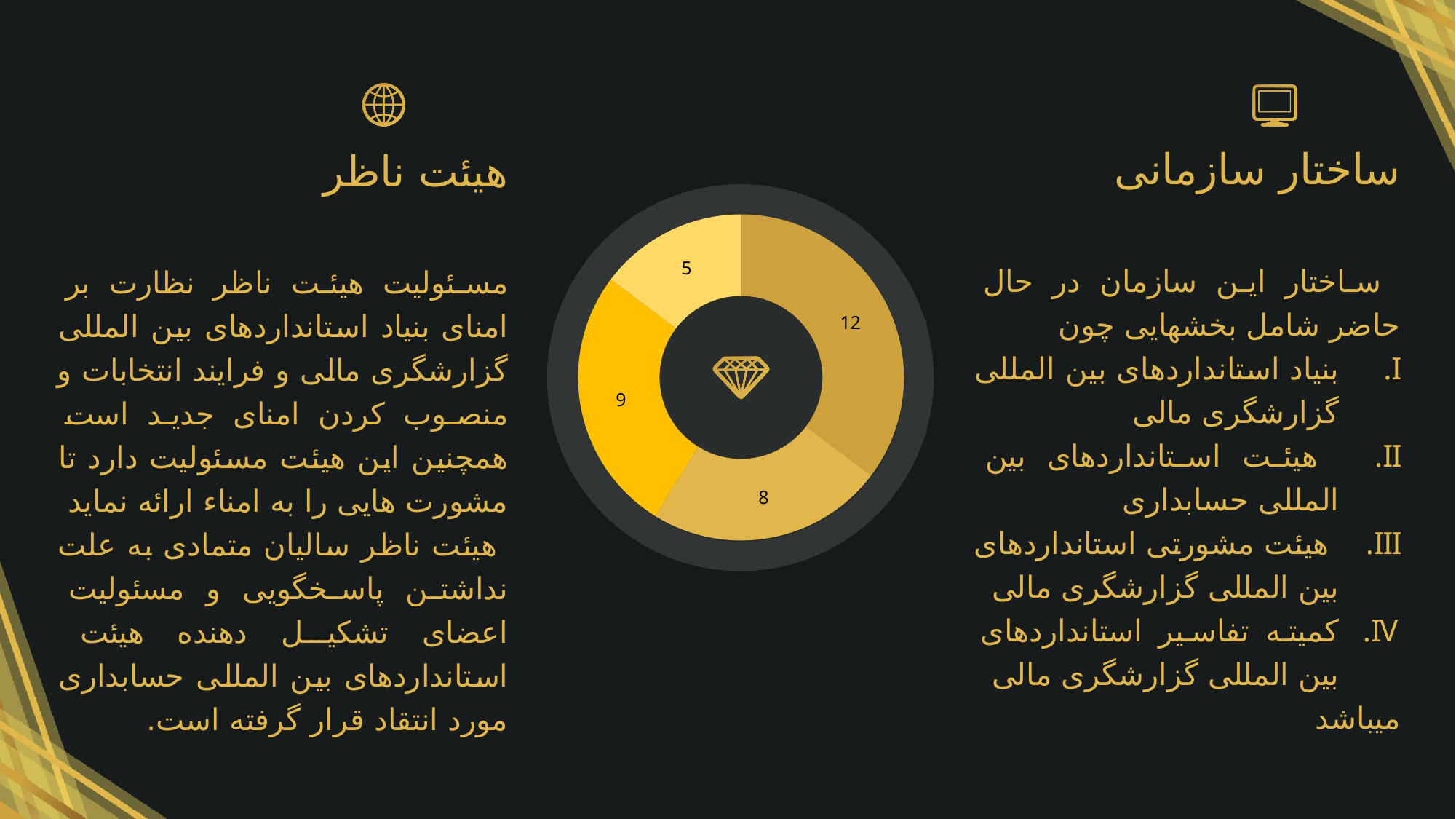
What is the difference between the slice labelled 9 and the slice labelled 8 in the doughnut chart? 1 What is the largest value shown on the doughnut chart? 12 Which is larger in the doughnut chart: the slice labelled 12 or the slice labelled 9? 12 How many slices does the doughnut chart have? 4 What is the total of all four slice values in the doughnut chart? 34 What value is labelled on the light yellow slice at the top left of the doughnut chart? 5 What is the smallest value shown on the doughnut chart? 5 What is the difference between the largest slice (12) and the smallest slice (5) in the doughnut chart? 7 What value is labelled on the dark gold slice on the right side of the doughnut chart? 12 What kind of chart is shown in the centre of the slide? doughnut chart What value is labelled on the slice at the bottom of the doughnut chart? 8 What value is labelled on the bright yellow slice on the left side of the doughnut chart? 9